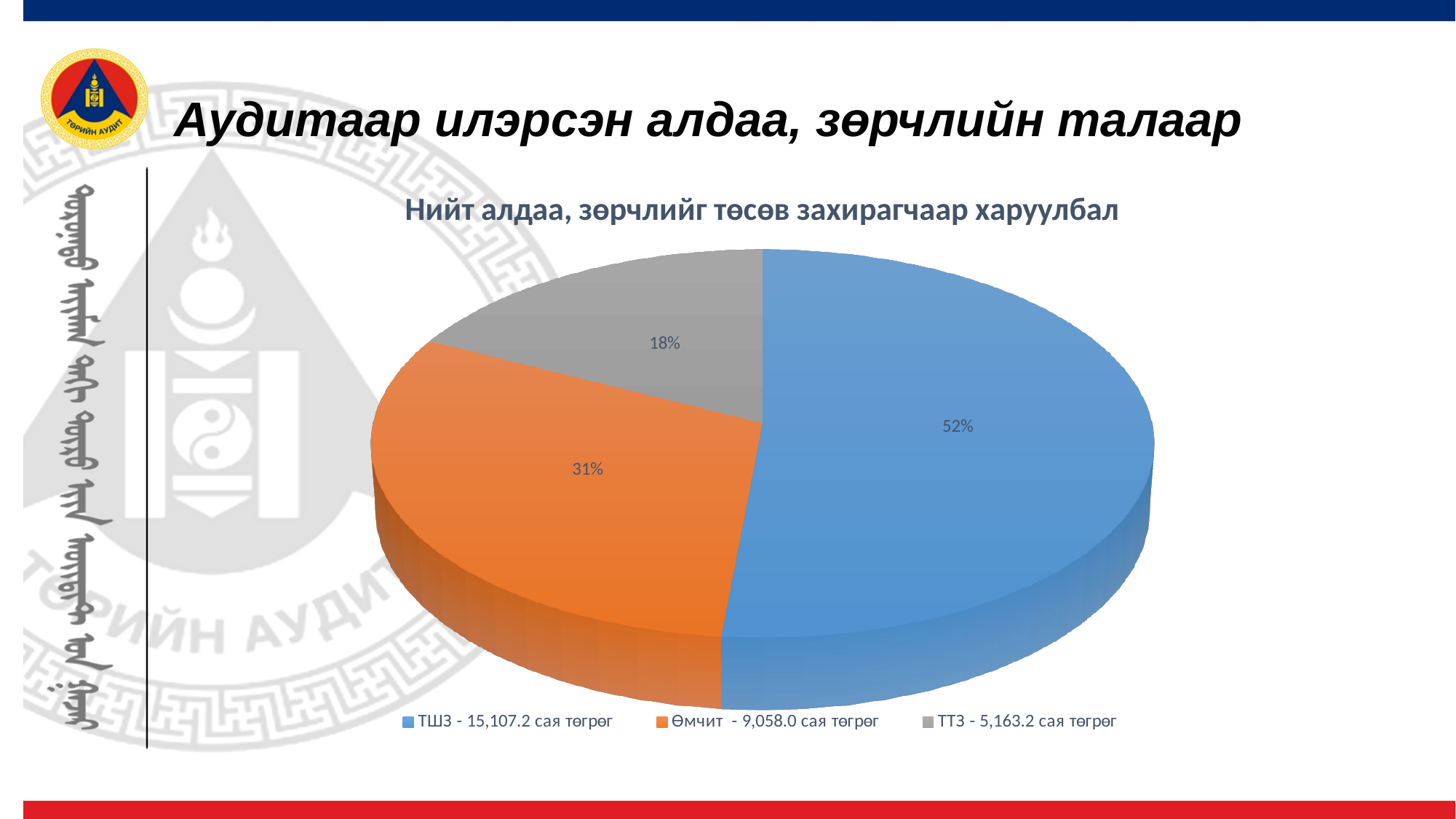
Which category has the smallest slice of the pie? ТТЗ What kind of chart is shown on the slide? Pie chart What is the title of the chart? Нийт алдаа, зөрчлийг төсөв захирагчаар харуулбал What share of the pie does the Өмчит slice represent? 31% What amount in сая төгрөг does the legend give for ТШЗ? 15,107.2 сая төгрөг What is the difference in percentage points between the ТШЗ slice and the Өмчит slice? 21 percentage points What colour is the Өмчит slice in the pie chart? Orange What share of the pie does the ТТЗ slice represent? 18% Which slice is larger, Өмчит or ТТЗ? Өмчит What share of the pie does the ТШЗ slice represent? 52% Which category has the largest slice of the pie? ТШЗ How many slices does the pie chart have? 3